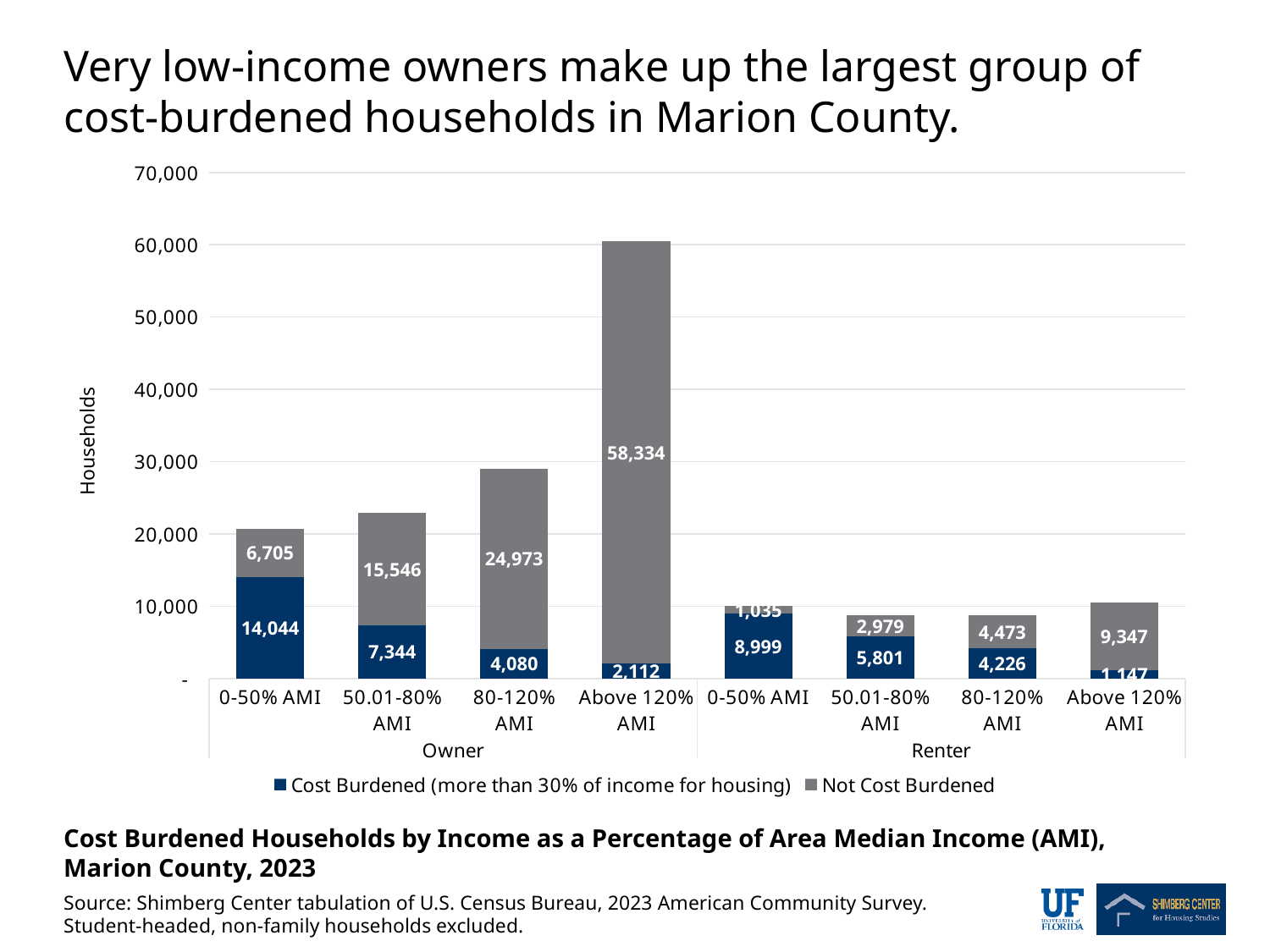
What is the difference between cost-burdened owner households and cost-burdened renter households in the 0-50% AMI group? 5,045 In the 50.01-80% AMI group, are there more cost-burdened owner households or cost-burdened renter households? Owner households How many income-group bars are shown in the chart? 8 Which income group and tenure has the largest number of cost-burdened households? 0-50% AMI owners Which income group and tenure has the smallest number of not cost-burdened households? 0-50% AMI renters How many cost-burdened owner households are in the 0-50% AMI group? 14,044 How many series does the legend list? 2 How many cost-burdened renter households are in the 50.01-80% AMI group? 5,801 Do the numbers of cost-burdened owner households rise or fall as income group increases from 0-50% AMI to Above 120% AMI? Fall What is the total number of owner households in the 80-120% AMI group (cost burdened plus not cost burdened)? 29,053 How many not cost-burdened owner households are in the Above 120% AMI group? 58,334 What kind of chart is shown on the slide? Stacked bar chart